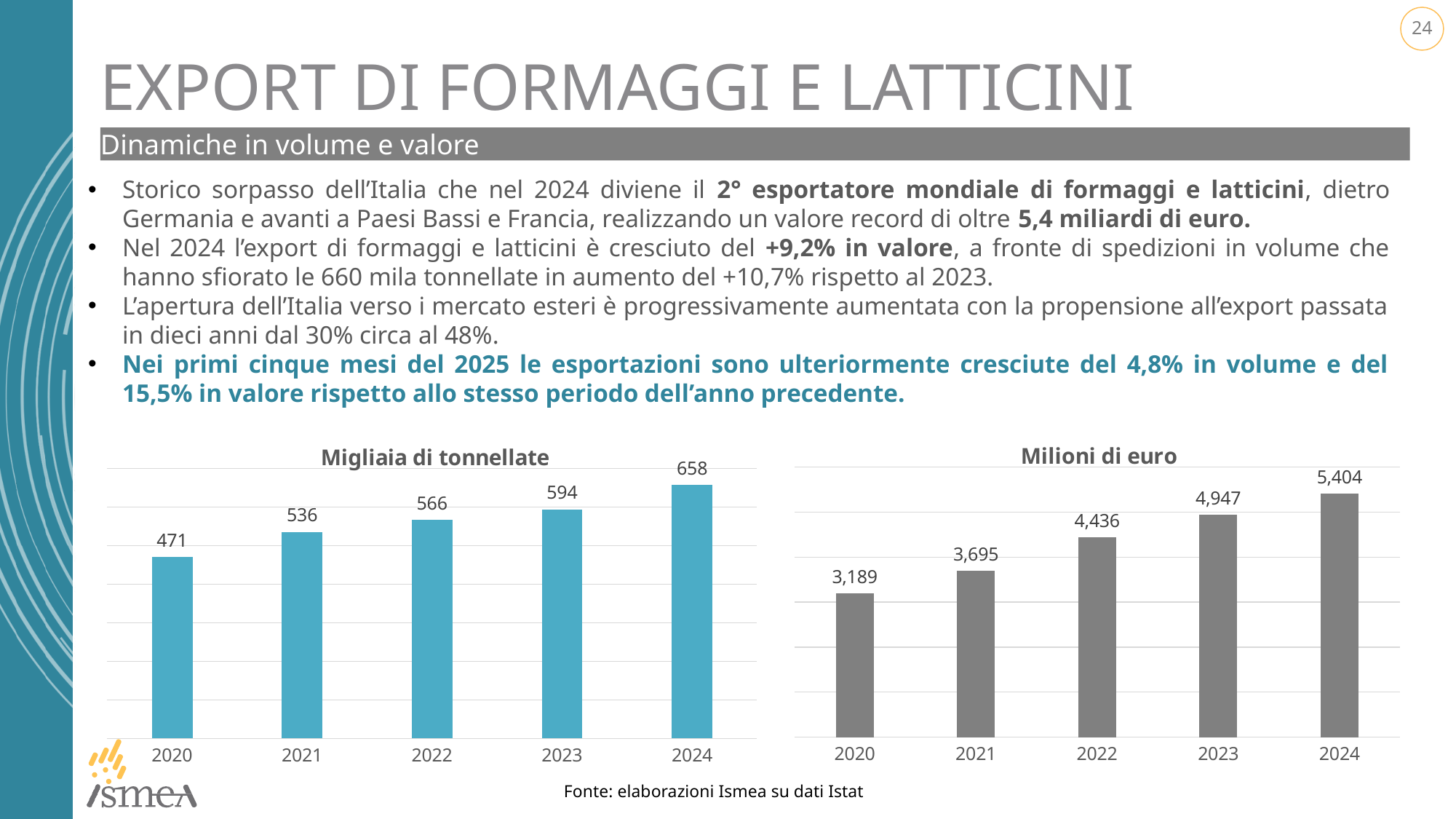
In the 'Migliaia di tonnellate' chart, do the values rise or fall from 2020 to 2024? Rise In the 'Milioni di euro' chart, what is the value for 2021? 3,695 How many years are shown in the 'Migliaia di tonnellate' chart? 5 What type of chart is the 'Milioni di euro' chart? Bar chart What colour are the bars in the 'Migliaia di tonnellate' chart? Blue In the 'Milioni di euro' chart, which year has the lowest value? 2020 In the 'Migliaia di tonnellate' chart, which year has the highest value? 2024 In the 'Migliaia di tonnellate' chart, what is the difference between the 2024 and 2020 values? 187 In the 'Milioni di euro' chart, what is the value for 2024? 5,404 In the 'Migliaia di tonnellate' chart, what is the value for 2022? 566 In the 'Milioni di euro' chart, what is the difference between the 2024 and 2023 values? 457 In the 'Milioni di euro' chart, which is larger, the value for 2022 or the value for 2021? 2022